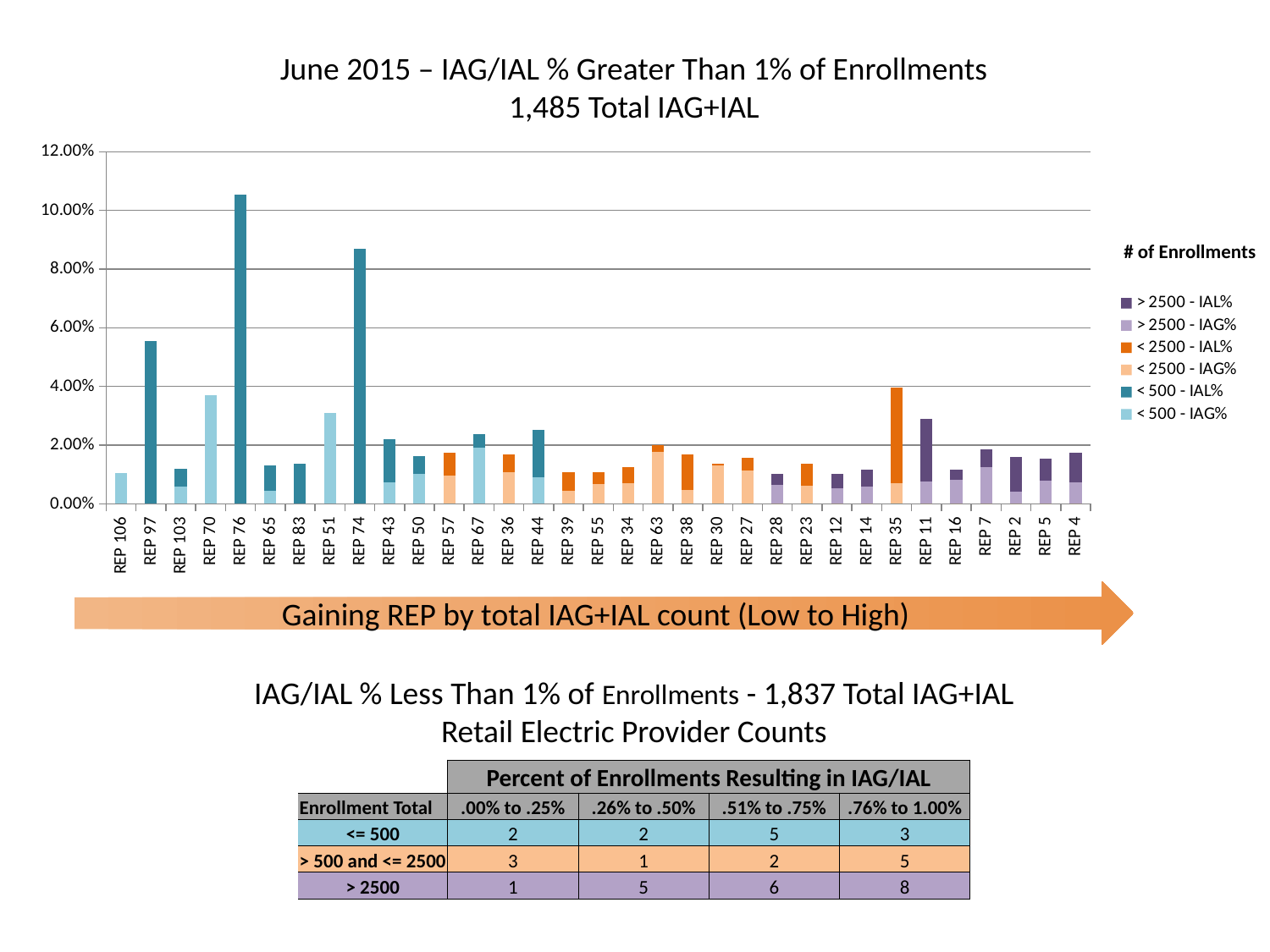
Is the value for REP 76 greater or less than 10.00%? greater Is the value for REP 74 greater or less than 8.00%? greater Which REP has the highest bar in the chart? REP 76 Is the value for REP 97 greater or less than 6.00%? less Which has the larger value, REP 97 or REP 70? REP 97 How many series does the chart legend list? 6 What is the heading shown above the chart legend? # of Enrollments What is the title of the chart? June 2015 – IAG/IAL % Greater Than 1% of Enrollments 1,485 Total IAG+IAL Which has the larger value, REP 76 or REP 74? REP 76 What kind of chart is shown on the slide? Bar chart How many REP categories are shown along the x axis of the chart? 33